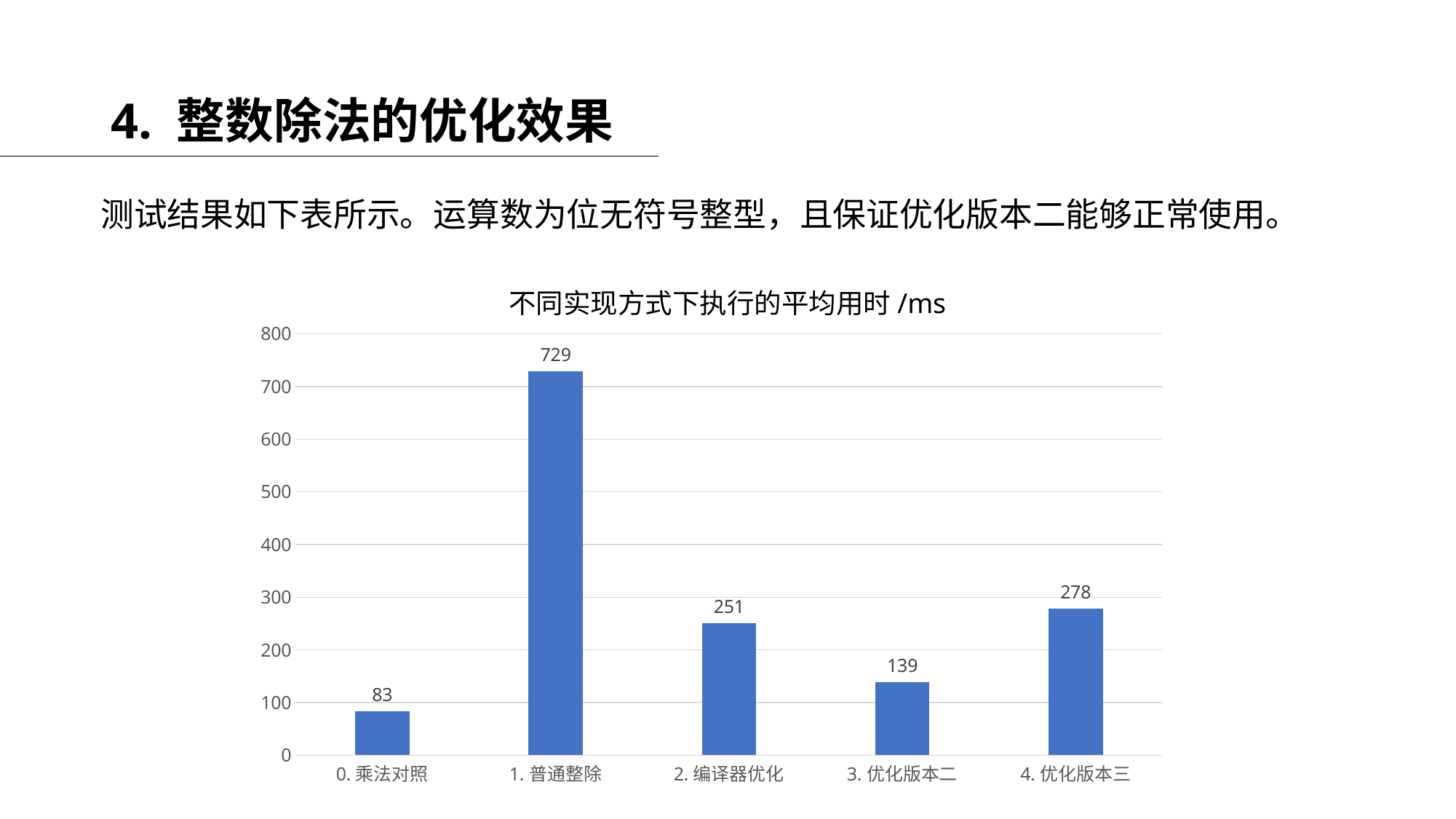
Which is larger, the value for 2. 编译器优化 or the value for 4. 优化版本三? 4. 优化版本三 What kind of chart is shown on the slide? bar chart What is the title of the chart? 不同实现方式下执行的平均用时 /ms What is the value for 0. 乘法对照? 83 Which category has the highest value? 1. 普通整除 Which category has the lowest value? 0. 乘法对照 What is the difference between the values for 4. 优化版本三 and 3. 优化版本二? 139 What is the difference between the values for 1. 普通整除 and 2. 编译器优化? 478 What is the value for 3. 优化版本二? 139 Is the value for 2. 编译器优化 greater or less than 300? less What is the value for 1. 普通整除? 729 How many categories are shown on the x axis? 5